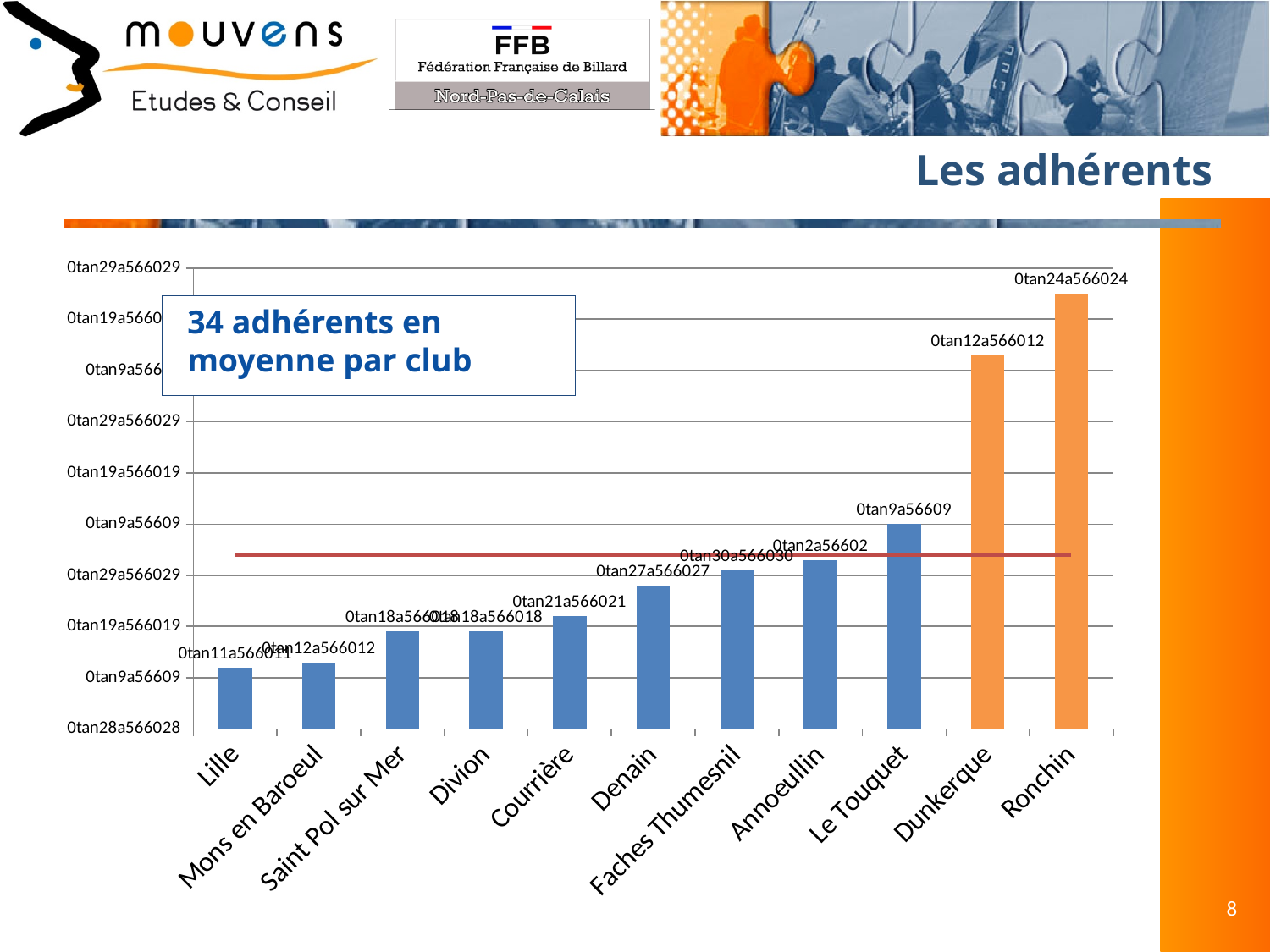
Which two clubs are shown with orange bars instead of blue? Dunkerque and Ronchin How many clubs (categories) are shown on the x axis of the chart? 11 Which has the larger bar, Le Touquet or Annoeullin? Le Touquet Which club has the lowest bar in the chart? Lille Which has the larger bar, Ronchin or Dunkerque? Ronchin What does the text box overlaid on the chart say? 34 adhérents en moyenne par club What kind of chart is shown on the slide? bar chart Which has the larger bar, Courrière or Denain? Denain Which club has the highest bar in the chart? Ronchin Do the bar values rise or fall from left to right along the x axis? rise